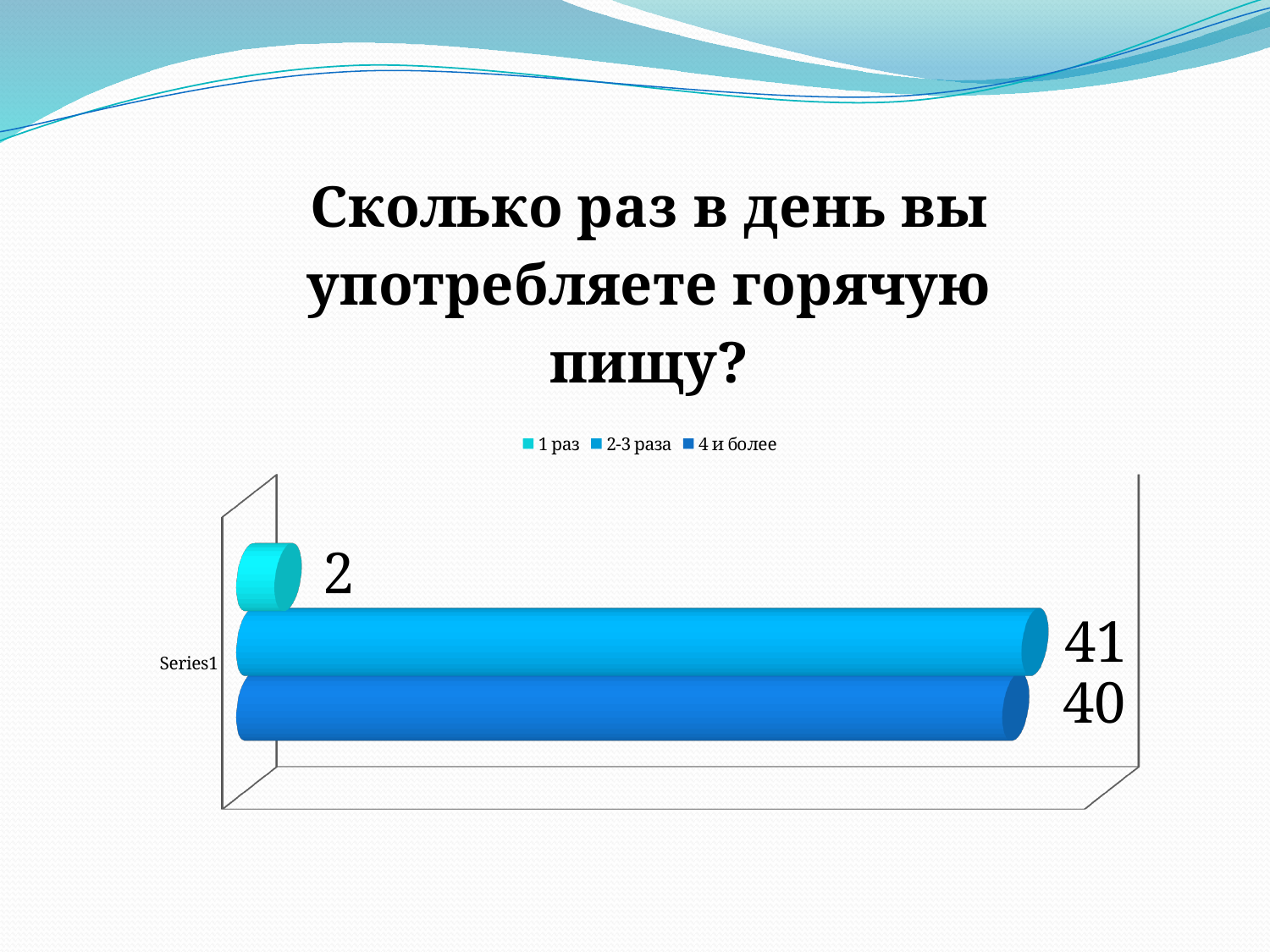
What is the difference between the values for "2-3 раза" and "1 раз"? 39 What kind of chart is shown on the slide? Bar chart Which is larger, the value for "4 и более" or the value for "1 раз"? 4 и более What is the value for "2-3 раза"? 41 What is the label on the category axis? Series1 What is the value for "4 и более"? 40 What is the value for "1 раз"? 2 Which legend entry has the lowest value? 1 раз What is the title of the chart? Сколько раз в день вы употребляете горячую пищу? How many series does the legend list? 3 What is the difference between the values for "2-3 раза" and "4 и более"? 1 Which legend entry has the highest value? 2-3 раза